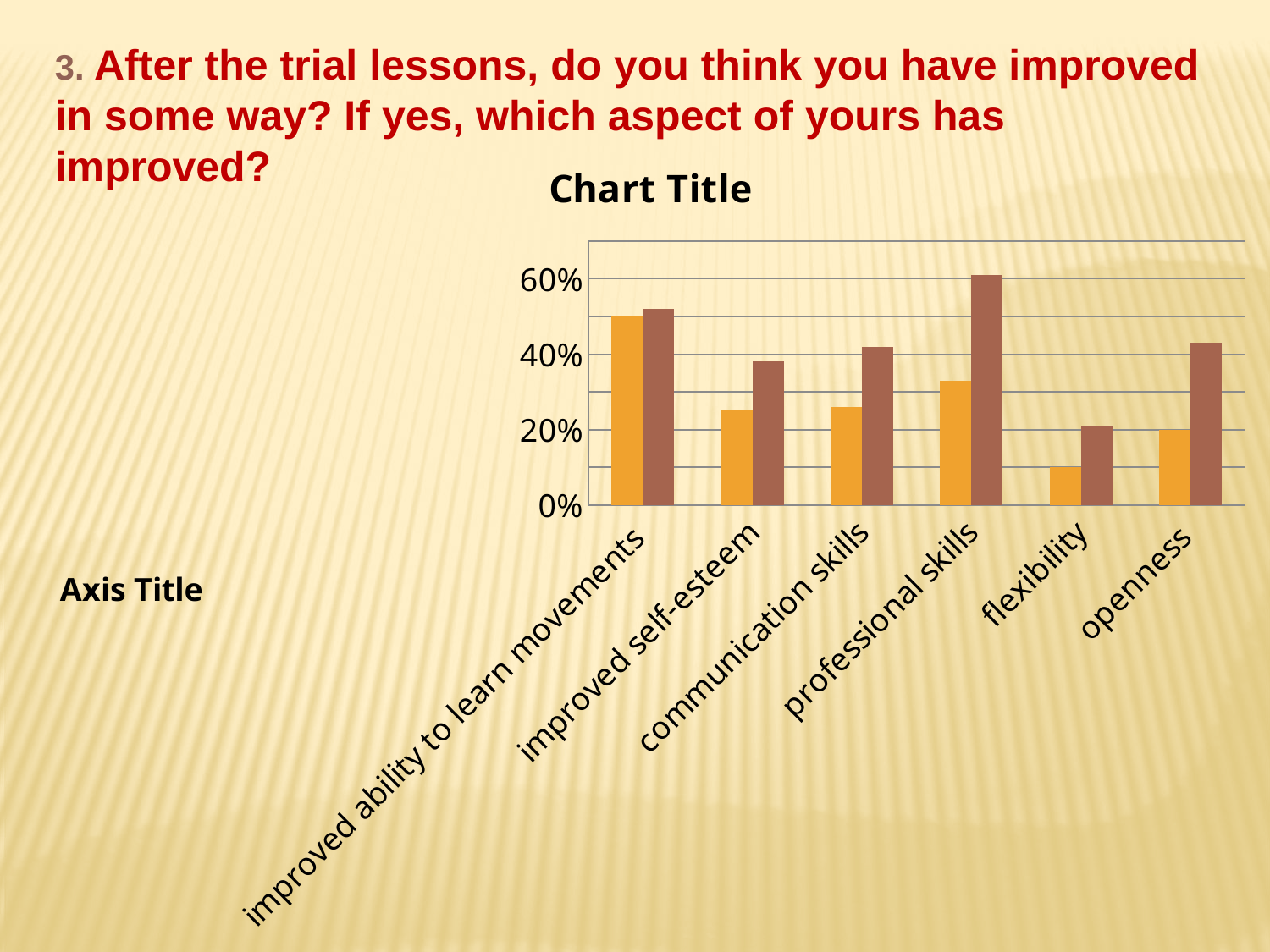
Which category has the tallest brown bar? professional skills Which category has the tallest orange bar? improved ability to learn movements What kind of chart is shown on the slide? bar chart Is the orange bar for flexibility greater or less than 20%? less How many bars are plotted for each category in the chart? 2 For professional skills, which bar is taller, the orange one or the brown one? the brown one Is the brown bar for professional skills greater or less than 40%? greater What is the title of the chart? Chart Title Which category has the shortest orange bar? flexibility Which category has the shortest brown bar? flexibility How many categories are shown on the x axis of the chart? 6 Is the orange bar for professional skills greater or less than 20%? greater